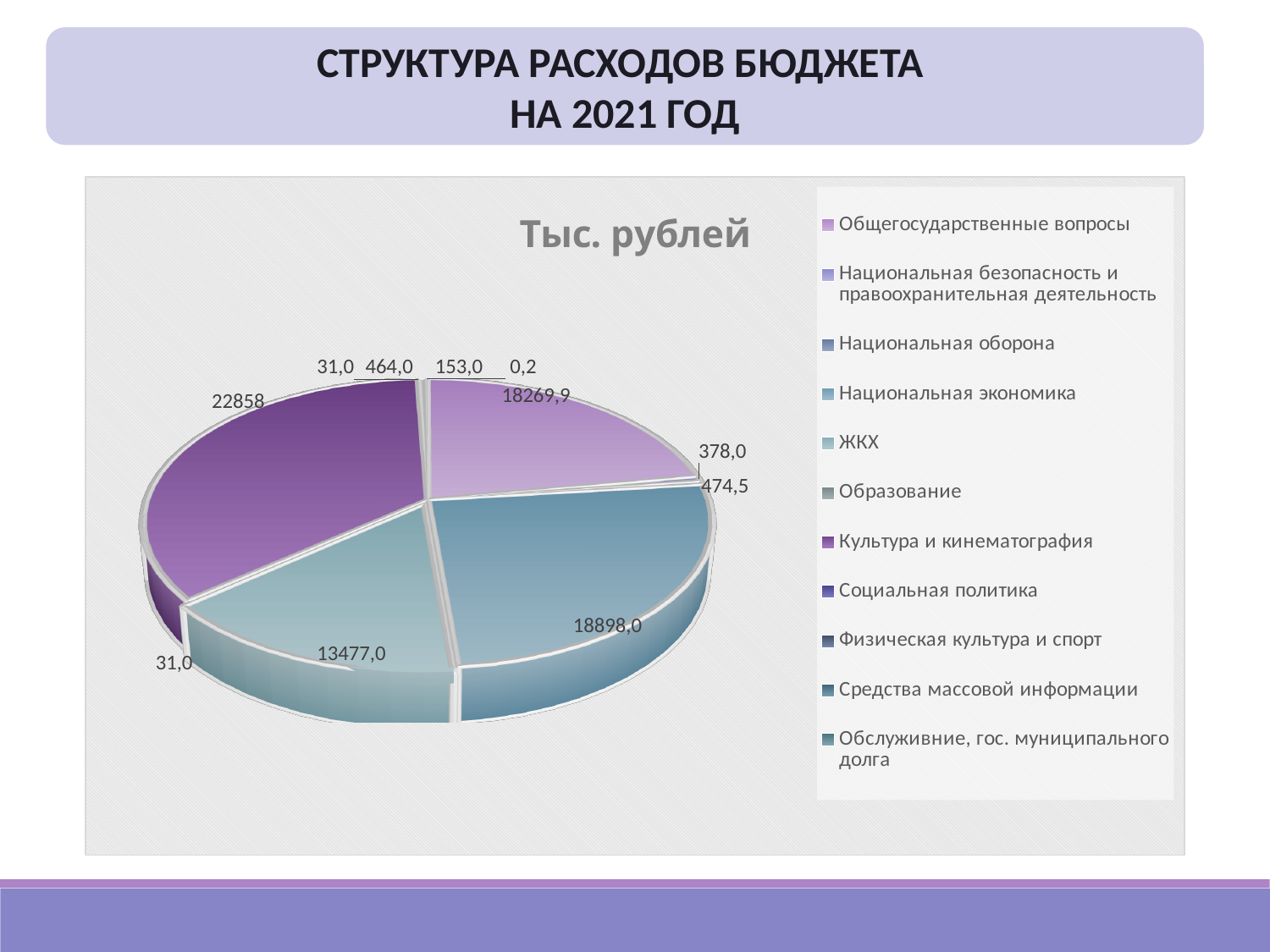
Which is larger, ЖКХ or Общегосударственные вопросы? Общегосударственные вопросы How many categories does the legend of the pie chart list? 11 What is the difference between Национальная экономика and ЖКХ? 5421,0 What is the smallest value labelled on the pie chart? 0,2 What is the value for ЖКХ? 13477,0 What is the largest value labelled on the pie chart? 22858 What is the value for Национальная экономика? 18898,0 Which is larger, Национальная экономика or Общегосударственные вопросы? Национальная экономика What is the difference between Национальная экономика and Общегосударственные вопросы? 628,1 What is the value for Общегосударственные вопросы? 18269,9 What is the title of the chart? Тыс. рублей What kind of chart is shown on the slide? pie chart